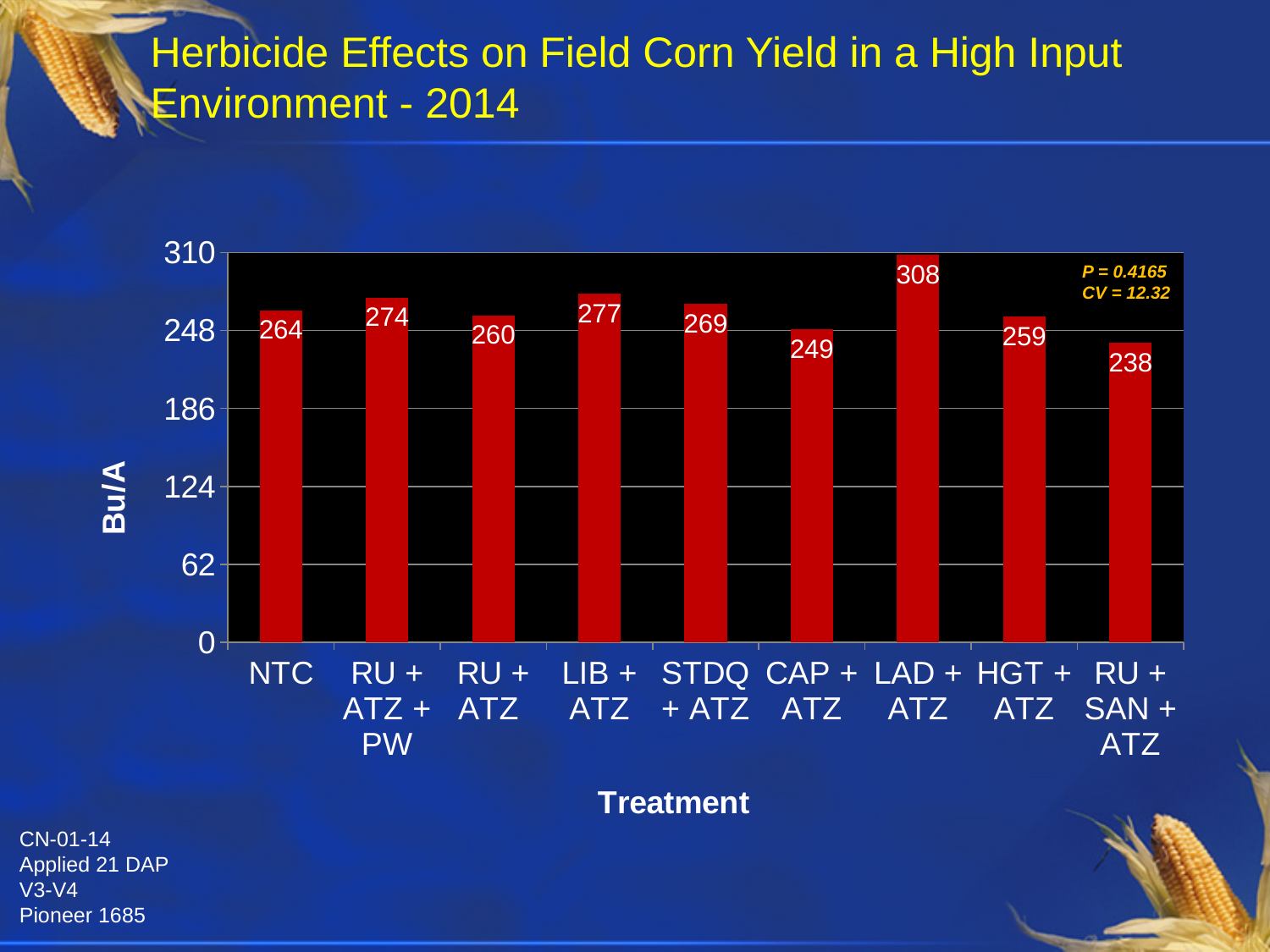
Which treatment has the lowest yield? RU + SAN + ATZ What is the difference in yield between LAD + ATZ and RU + SAN + ATZ? 70 What is the difference in yield between LIB + ATZ and RU + ATZ? 17 What is the y-axis label of the chart? Bu/A Is the yield for STDQ + ATZ greater or less than 248? greater Which treatment has the highest yield? LAD + ATZ What is the yield (Bu/A) for the CAP + ATZ treatment? 249 How many treatments are shown on the chart? 9 What is the yield (Bu/A) for the NTC treatment? 264 Which has a higher yield, RU + ATZ + PW or HGT + ATZ? RU + ATZ + PW What kind of chart is shown on the slide? Bar chart What is the yield (Bu/A) for the LAD + ATZ treatment? 308